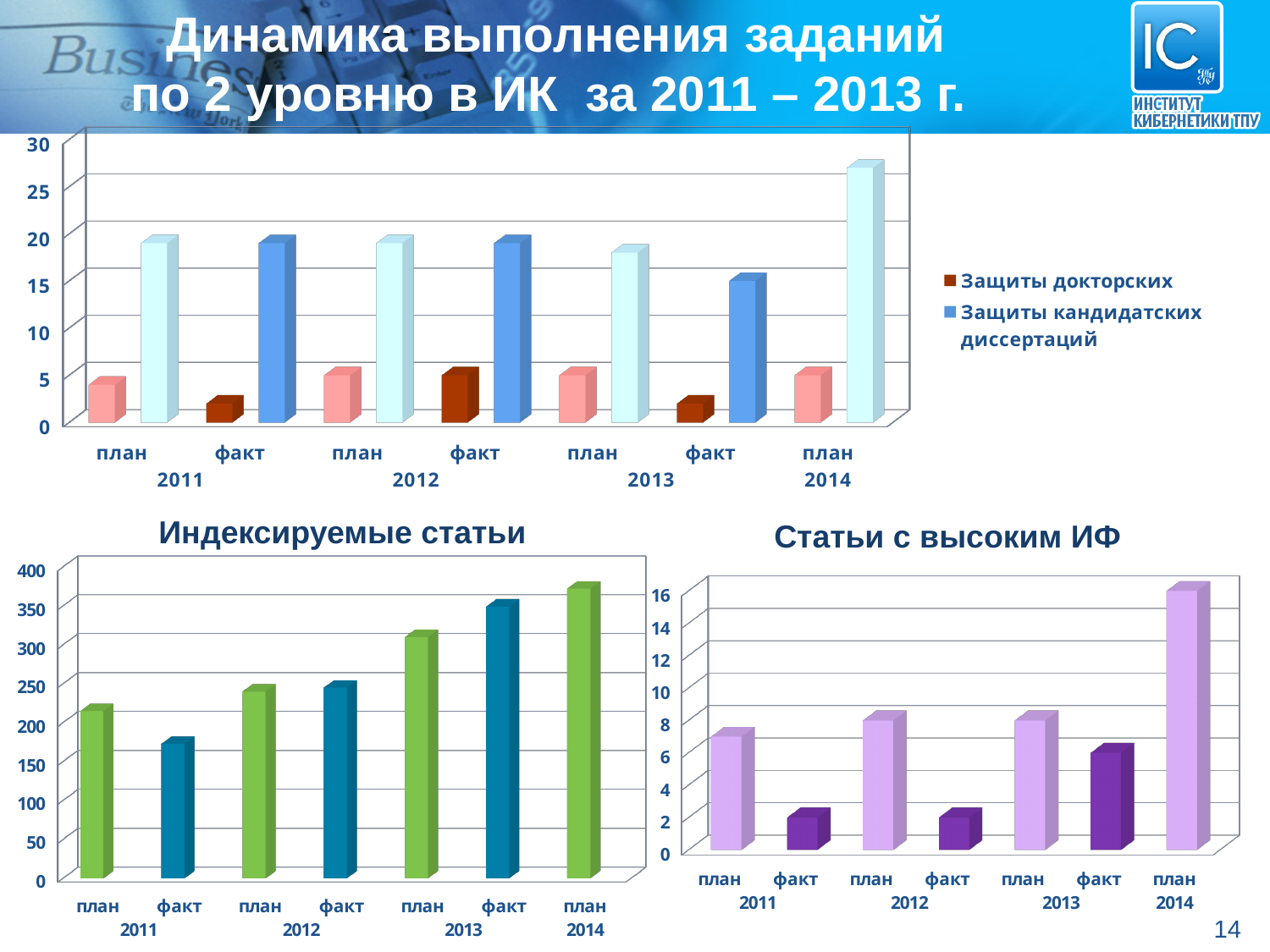
In the chart 'Статьи с высоким ИФ', which category has the highest value? план 2014 In the chart 'Индексируемые статьи', which category has the lowest value? факт 2011 How many series does the legend of the top chart list? 2 In the chart 'Индексируемые статьи', is the value for план 2014 greater or less than 350? greater In the chart 'Индексируемые статьи', how many bars are plotted? 7 In the chart 'Индексируемые статьи', do the план values rise or fall from 2011 to 2014? rise What kind of chart is the top chart on the slide? bar chart In the top chart, which is larger for Защиты кандидатских диссертаций: план 2011 or план 2014? план 2014 In the top chart, is the value of Защиты докторских for факт 2011 greater or less than 5? less In the top chart, which category has the highest value for Защиты кандидатских диссертаций? план 2014 In the top chart, is the value of Защиты кандидатских диссертаций for план 2014 greater or less than 25? greater In the chart 'Статьи с высоким ИФ', which is larger: факт 2012 or факт 2013? факт 2013